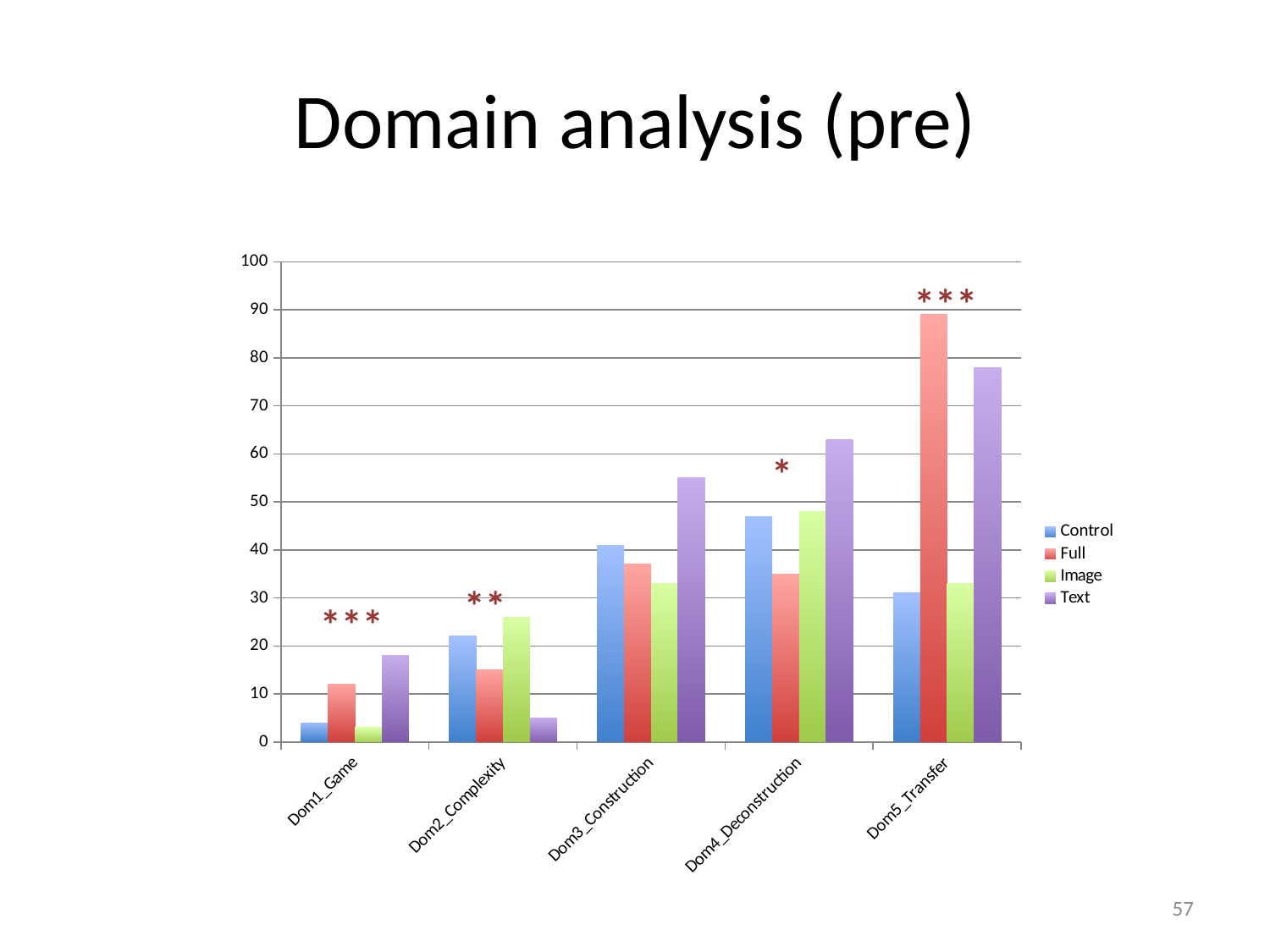
Which is larger for Dom2_Complexity, the Image value or the Full value? Image How many categories are shown on the x axis? 5 Which series has the highest value for Dom5_Transfer? Full Is the value for Full in Dom5_Transfer greater or less than 80? greater Is the value for Text in Dom1_Game greater or less than 20? less What is the title of the slide containing the chart? Domain analysis (pre) Which series has the lowest value for Dom2_Complexity? Text How many series does the legend list? 4 What kind of chart is shown on the slide? bar chart Which is larger for Dom4_Deconstruction, the Control value or the Full value? Control Which series has the highest value for Dom3_Construction? Text Is the value for Text in Dom4_Deconstruction greater or less than 60? greater